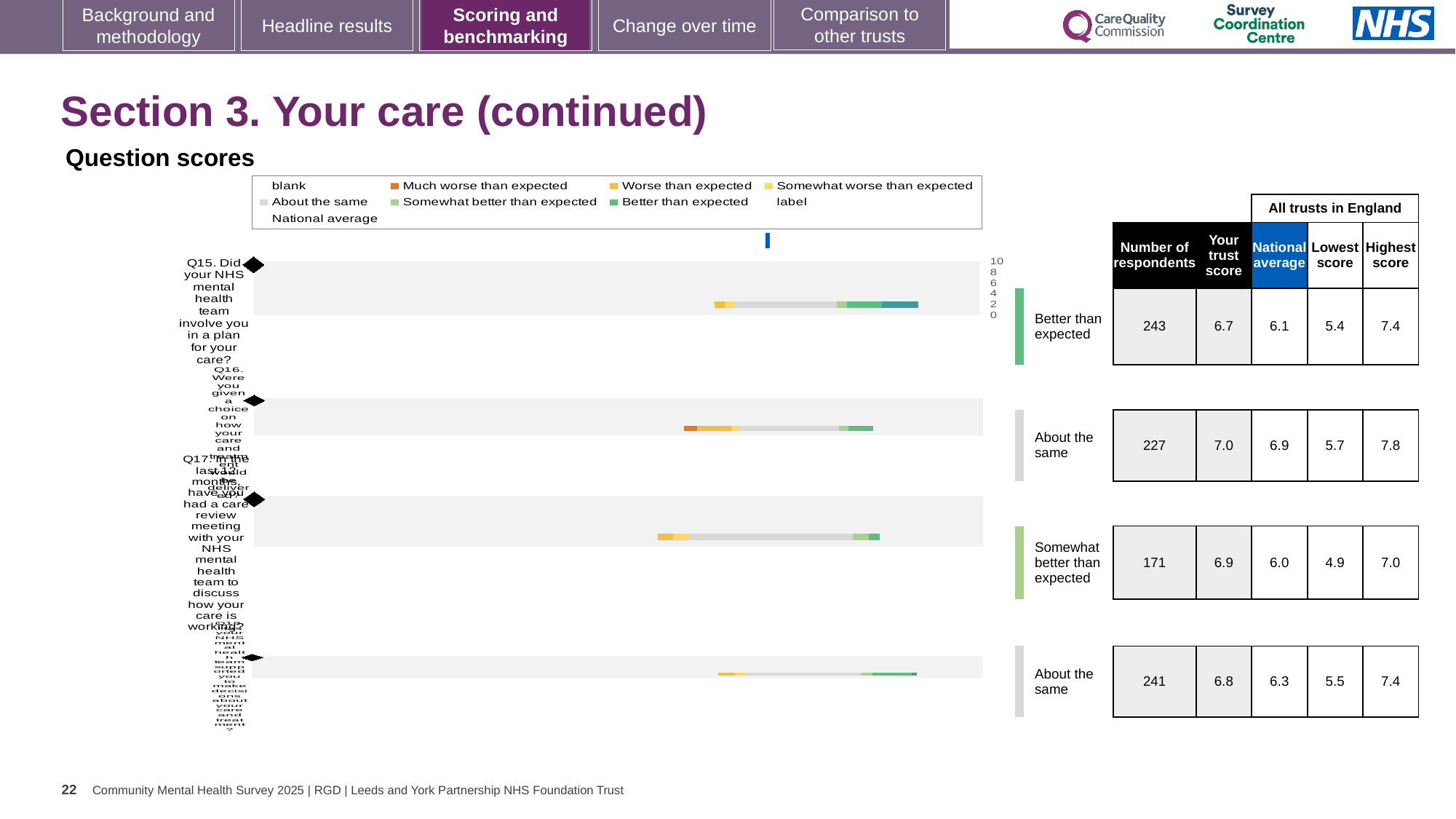
What is the trust score for Q15 (involving you in a plan for your care)? 6.7 What is the highest score across all trusts in England for Q18? 7.4 Which question has the lowest number of respondents? Q17 For Q17, which is larger: the trust score or the national average? the trust score What benchmark category is shown for Q15? Better than expected What kind of chart is shown under 'Question scores'? bar chart How many respondents answered Q17 (care review meeting in the last 12 months)? 171 What is the difference between the trust score and the national average for Q15? 0.6 What benchmark category is shown for Q17? Somewhat better than expected How many questions (rows) are plotted in the chart? 4 Which question has the highest trust score? Q16 What is the national average for Q16 (given a choice on how your care and treatment would be delivered)? 6.9